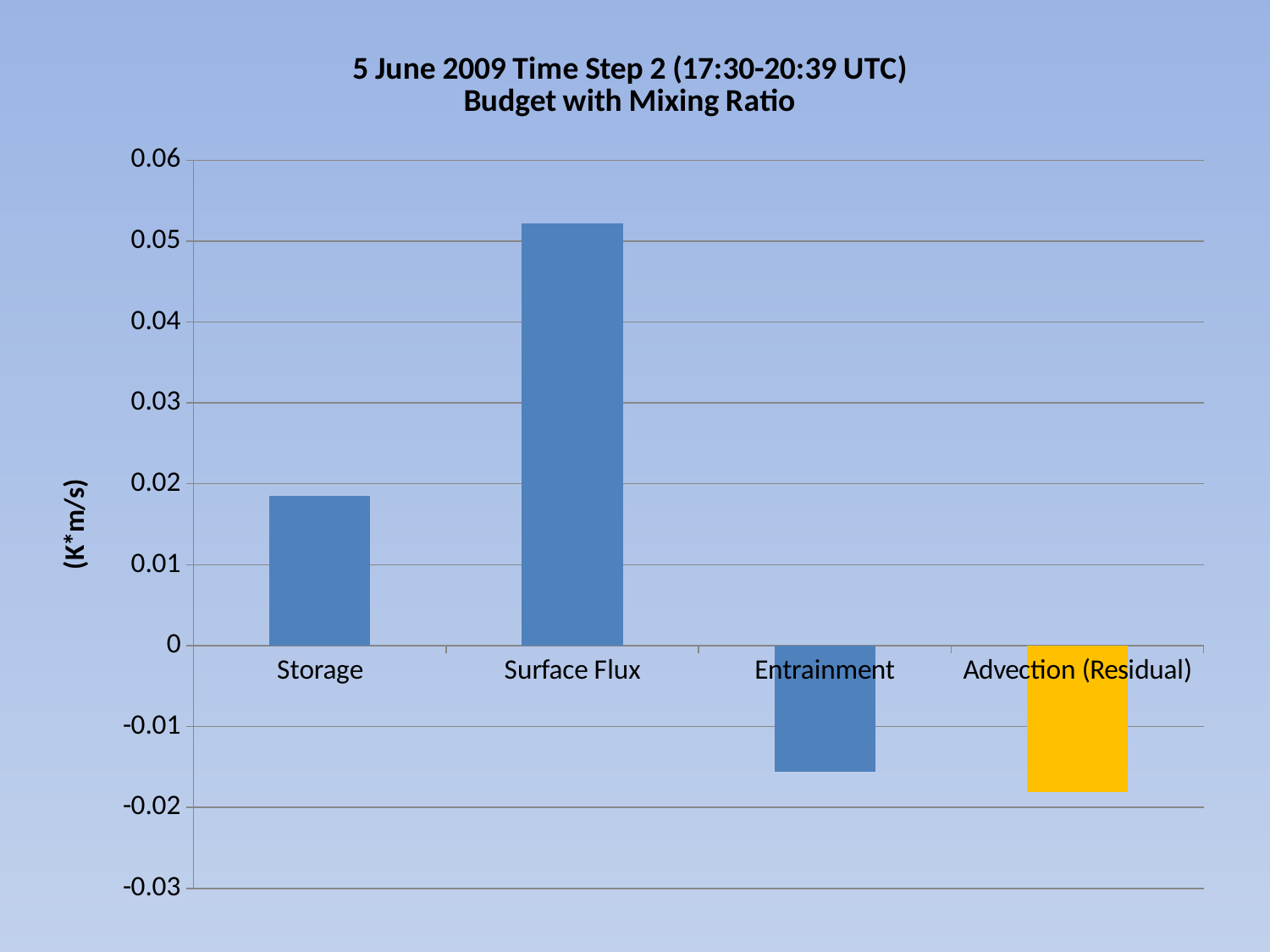
Is the value for Advection (Residual) greater or less than -0.02? greater Which category's bar is coloured yellow? Advection (Residual) What kind of chart is shown on the slide? bar chart How many categories are plotted on the chart? 4 Which category has the lowest value? Advection (Residual) Is the value for Storage greater or less than 0.02? less Which category has the highest value? Surface Flux Is the value for Storage greater or less than 0.01? greater Which is larger, the value for Storage or the value for Surface Flux? Surface Flux What is the label on the vertical axis? (K*m/s)